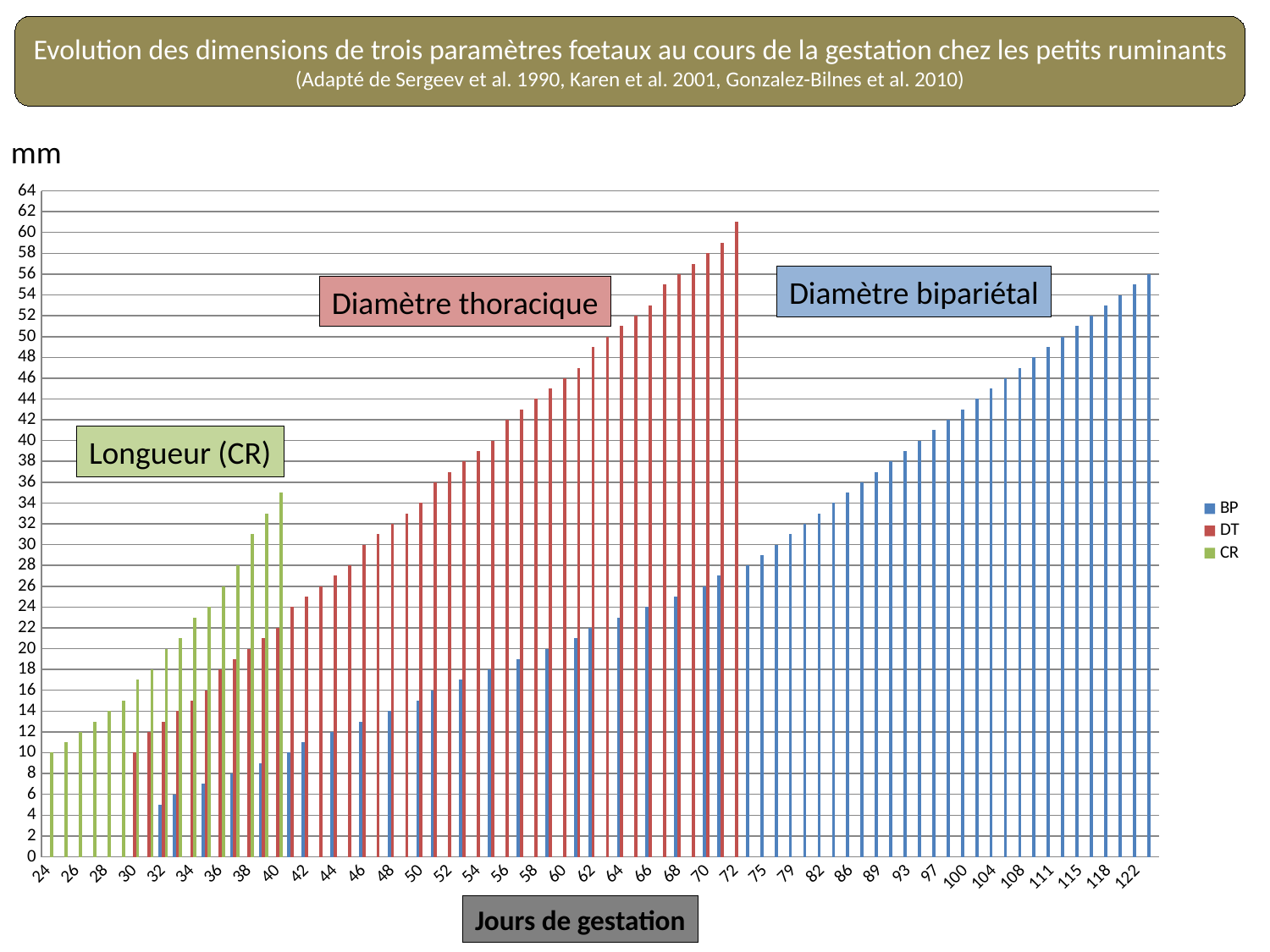
Do the CR (Longueur) values rise or fall as the days of gestation increase? rise What is the x-axis title of the chart? Jours de gestation Is the BP value at day 32 greater or less than 10? less Is the CR value at day 24 greater or less than 12? less What are the three series names listed in the legend? BP, DT, CR Do the BP (Diamètre bipariétal) values rise or fall as the days of gestation increase? rise Is the BP value at day 122 greater or less than 50? greater At day 70, which series has the larger value, DT or BP? DT At day 40, which series has the larger value, CR or DT? CR How many series does the legend list? 3 What type of chart is shown on the slide? bar chart